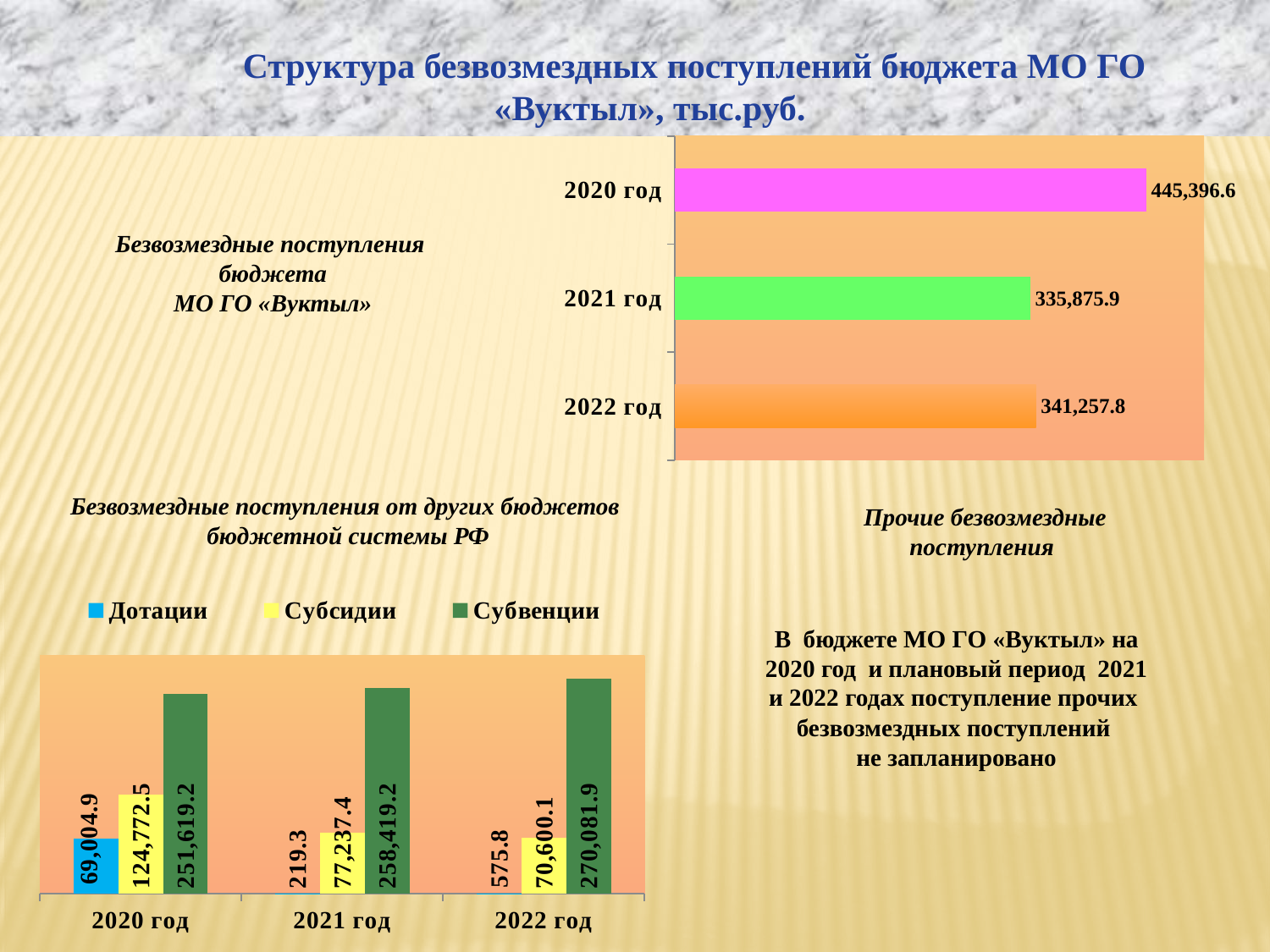
In the chart 'Безвозмездные поступления от других бюджетов бюджетной системы РФ', what is the value of Дотации for 2021 год? 219.3 In the chart 'Безвозмездные поступления от других бюджетов бюджетной системы РФ', what is the value of Субсидии for 2020 год? 124,772.5 In the chart 'Безвозмездные поступления бюджета МО ГО «Вуктыл»', which year has the lowest value? 2021 год In the chart 'Безвозмездные поступления от других бюджетов бюджетной системы РФ', how many series does the legend list? 3 In the chart 'Безвозмездные поступления бюджета МО ГО «Вуктыл»', what is the difference between the values for 2020 год and 2021 год? 109,520.7 In the chart 'Безвозмездные поступления от других бюджетов бюджетной системы РФ', what is the difference between Субвенции for 2022 год and 2020 год? 18,462.7 In the chart 'Безвозмездные поступления бюджета МО ГО «Вуктыл»', what is the value for 2020 год? 445,396.6 In the chart 'Безвозмездные поступления бюджета МО ГО «Вуктыл»', how many years are shown? 3 In the chart 'Безвозмездные поступления бюджета МО ГО «Вуктыл»', what is the value for 2022 год? 341,257.8 In the chart 'Безвозмездные поступления от других бюджетов бюджетной системы РФ', which year has the highest value of Субвенции? 2022 год What kind of chart is 'Безвозмездные поступления бюджета МО ГО «Вуктыл»'? Bar chart In the chart 'Безвозмездные поступления от других бюджетов бюджетной системы РФ', do the values of Субсидии rise or fall from 2020 год to 2022 год? Fall